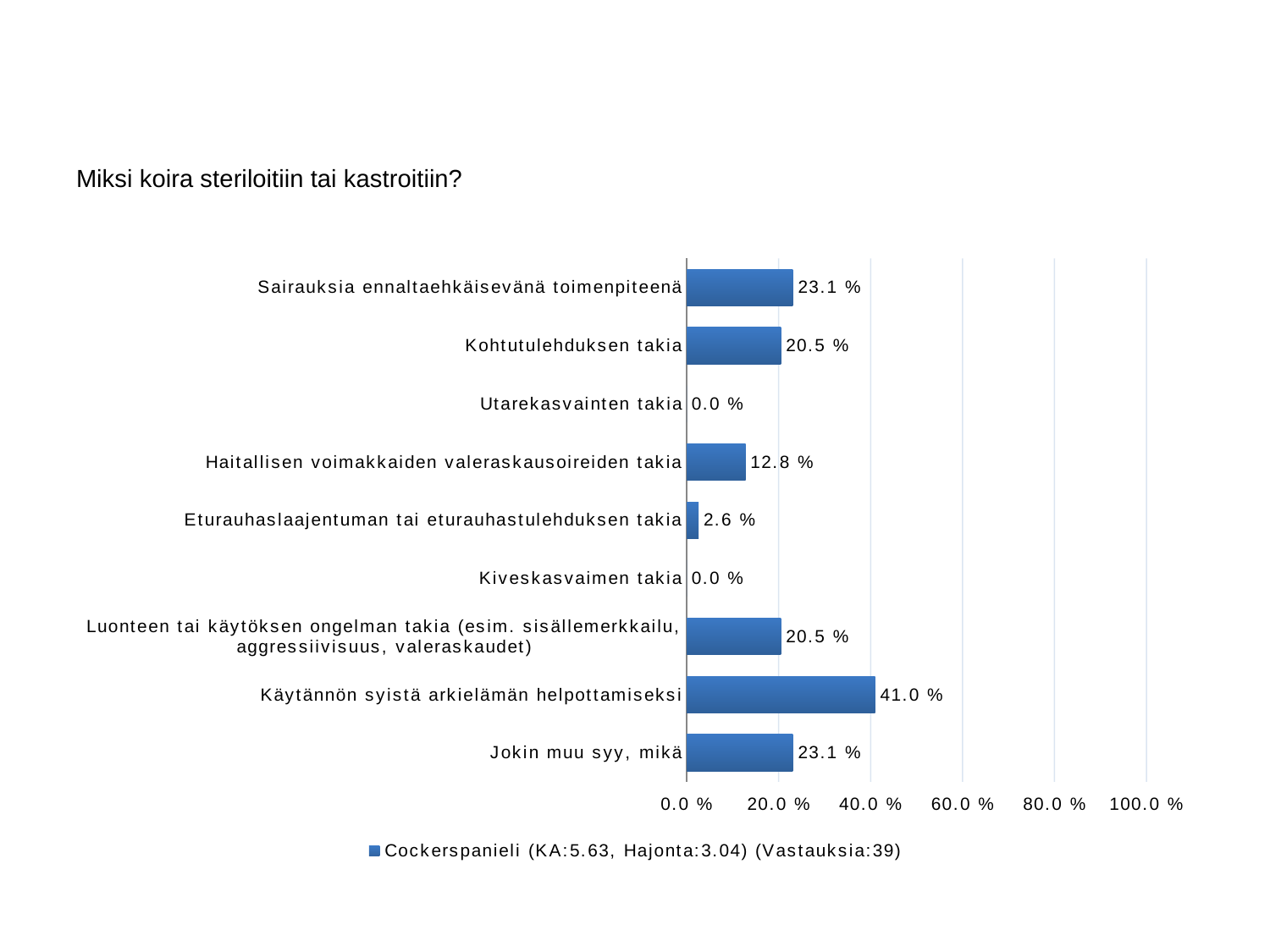
How many categories have a value of 0.0 %? 2 How many series does the legend list? 1 Is the value for "Käytännön syistä arkielämän helpottamiseksi" greater or less than 40.0 %? greater How many categories are shown on the chart? 9 What kind of chart is shown on the slide? bar chart Which category has the highest value? Käytännön syistä arkielämän helpottamiseksi What is the difference between the values for "Käytännön syistä arkielämän helpottamiseksi" and "Kohtutulehduksen takia"? 20.5 % Which is larger: the value for "Sairauksia ennaltaehkäisevänä toimenpiteenä" or the value for "Haitallisen voimakkaiden valeraskausoireiden takia"? Sairauksia ennaltaehkäisevänä toimenpiteenä What is the title of the slide? Miksi koira steriloitiin tai kastroitiin? What is the value for "Eturauhaslaajentuman tai eturauhastulehduksen takia"? 2.6 % What is the value for "Käytännön syistä arkielämän helpottamiseksi"? 41.0 % What is the value for "Haitallisen voimakkaiden valeraskausoireiden takia"? 12.8 %